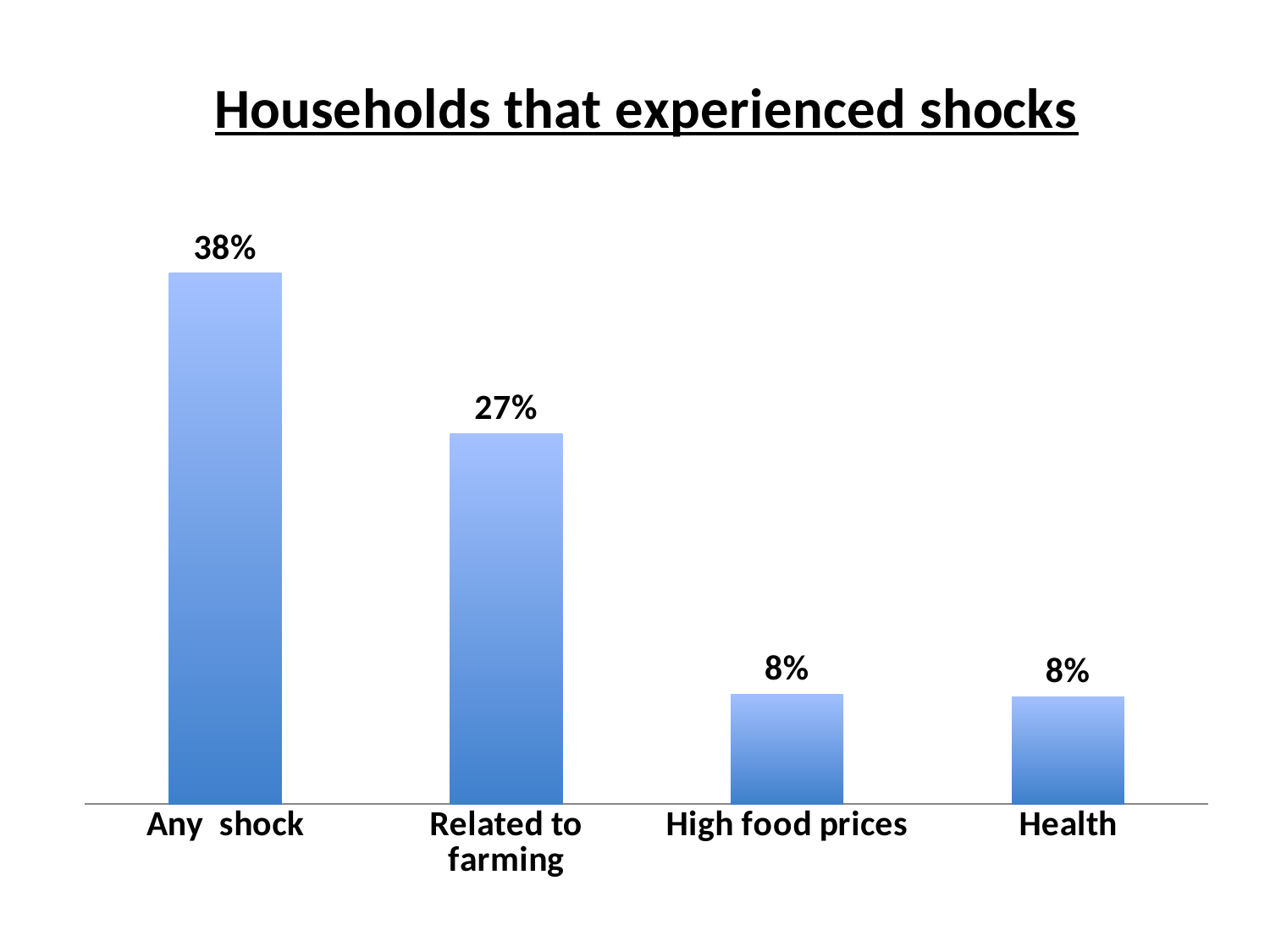
What is the value for Health? 8% What kind of chart is shown on the slide? Bar chart What is the value for high food prices? 8% Which category has the highest value? Any shock What percentage of households experienced any shock? 38% How many categories are shown in the chart? 4 Which is larger, the value for Related to farming or the value for High food prices? Related to farming Do the values rise or fall from left to right across the categories? Fall What is the title of the chart? Households that experienced shocks What is the difference between the values for Any shock and Related to farming? 11% What is the difference between the values for Related to farming and Health? 19% What is the value for shocks related to farming? 27%